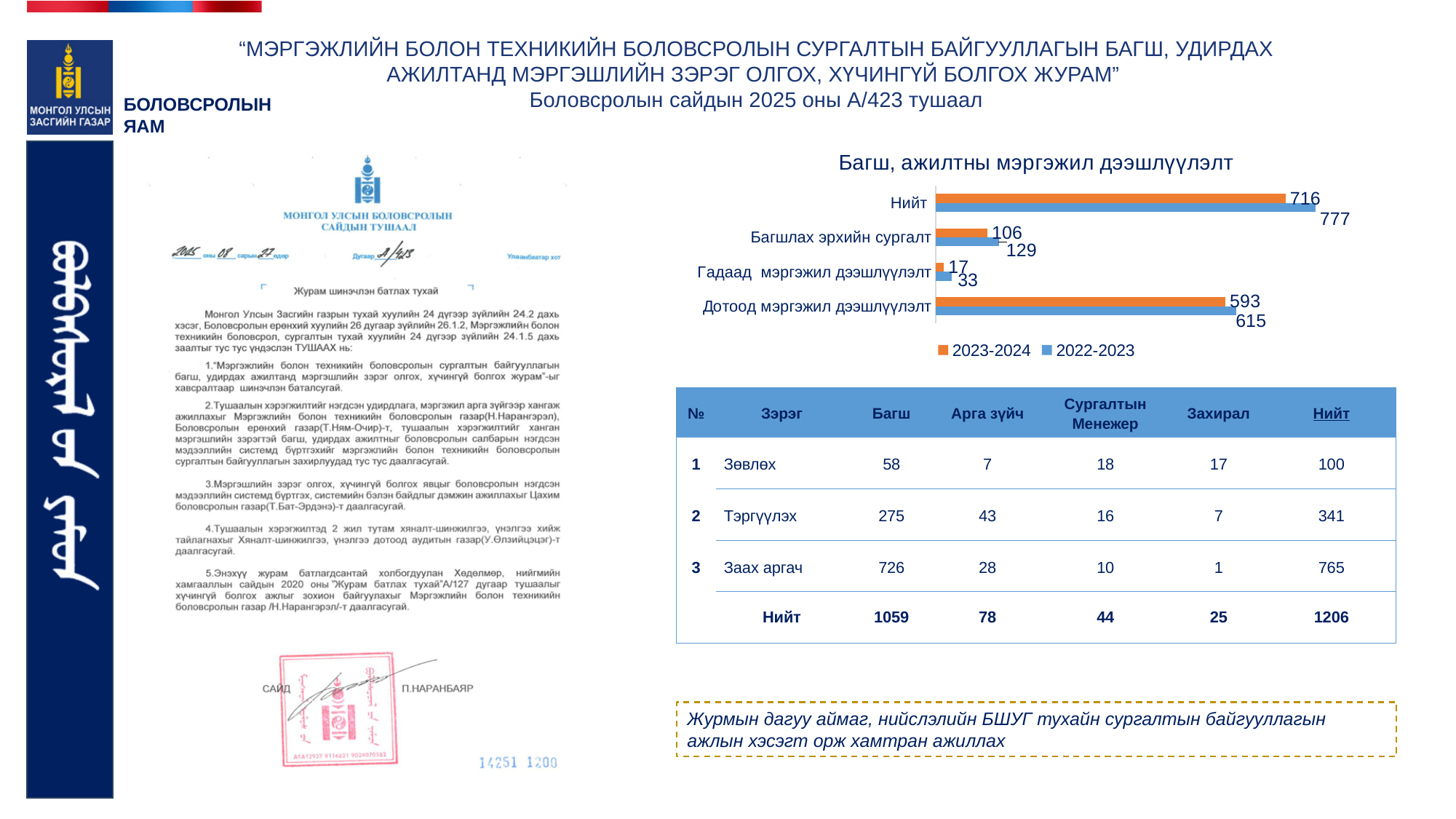
How many categories are shown on the chart? 4 What is the 2023-2024 value for Нийт in the chart? 716 What is the 2022-2023 value for Гадаад мэргэжил дээшлүүлэлт? 33 Which category has the lowest 2023-2024 value in the chart? Гадаад мэргэжил дээшлүүлэлт What is the 2022-2023 value for Дотоод мэргэжил дээшлүүлэлт? 615 What is the 2022-2023 value for Нийт in the chart? 777 How many series does the legend of the chart list? 2 What type of chart is "Багш, ажилтны мэргэжил дээшлүүлэлт"? bar chart Which is larger for Дотоод мэргэжил дээшлүүлэлт: the 2023-2024 value or the 2022-2023 value? 2022-2023 Which colour represents the 2023-2024 series in the chart? orange What is the 2023-2024 value for Багшлах эрхийн сургалт? 106 What is the difference between the 2022-2023 and 2023-2024 values for Нийт? 61